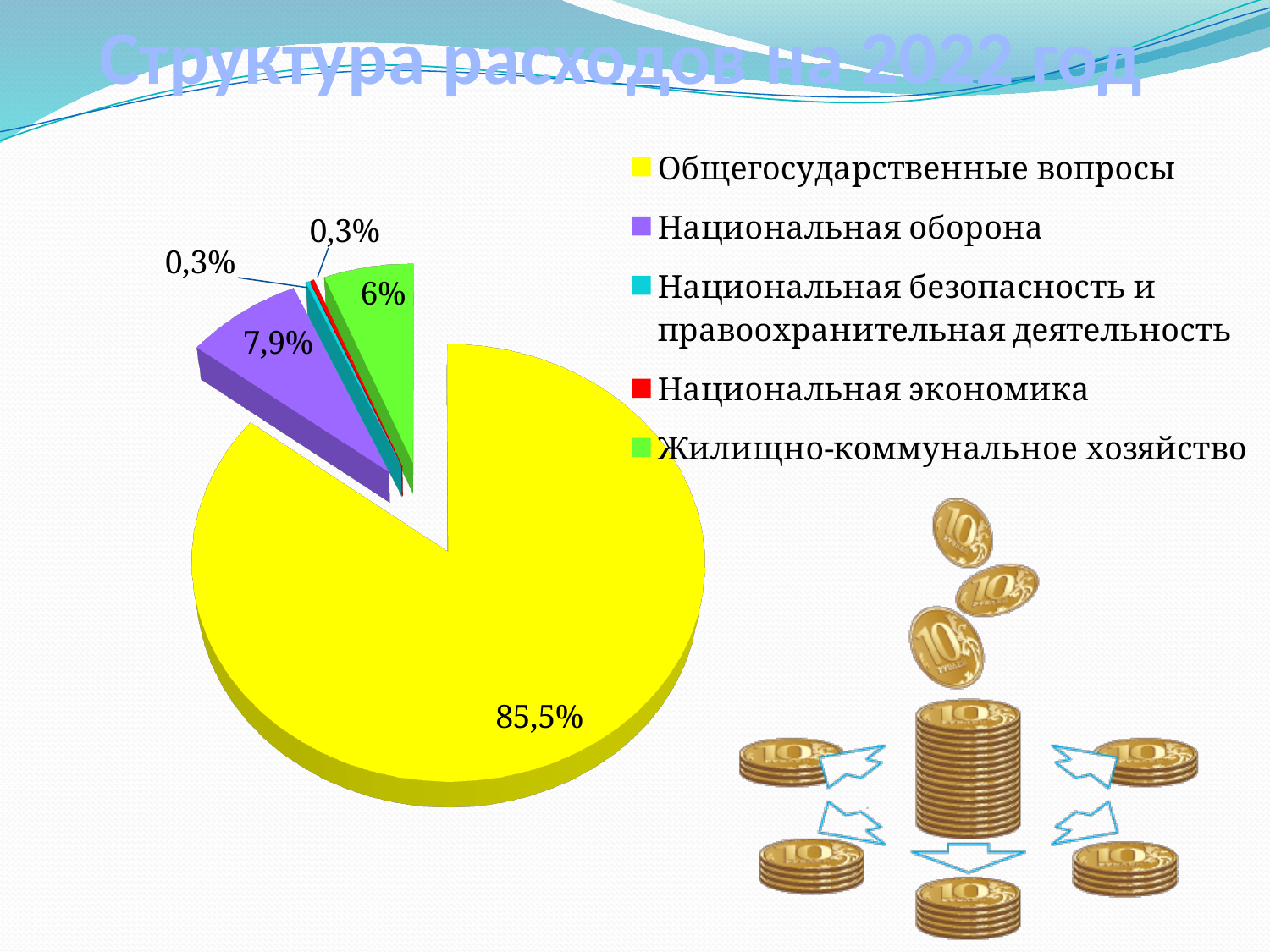
What kind of chart is shown on the slide? pie chart What colour is the slice for Национальная оборона? purple Which category has the largest share of the pie? Общегосударственные вопросы Which is larger, Национальная оборона or Жилищно-коммунальное хозяйство? Национальная оборона What is the title of the chart? Структура расходов на 2022 год How many categories does the legend list? 5 What is the value shown for Жилищно-коммунальное хозяйство? 6% What is the value shown for Национальная безопасность и правоохранительная деятельность? 0,3% What share of the pie does Общегосударственные вопросы take? 85,5% What is the difference between the shares of Общегосударственные вопросы and Национальная оборона? 77,6% What is the value shown for Национальная экономика? 0,3% What is the value shown for Национальная оборона? 7,9%